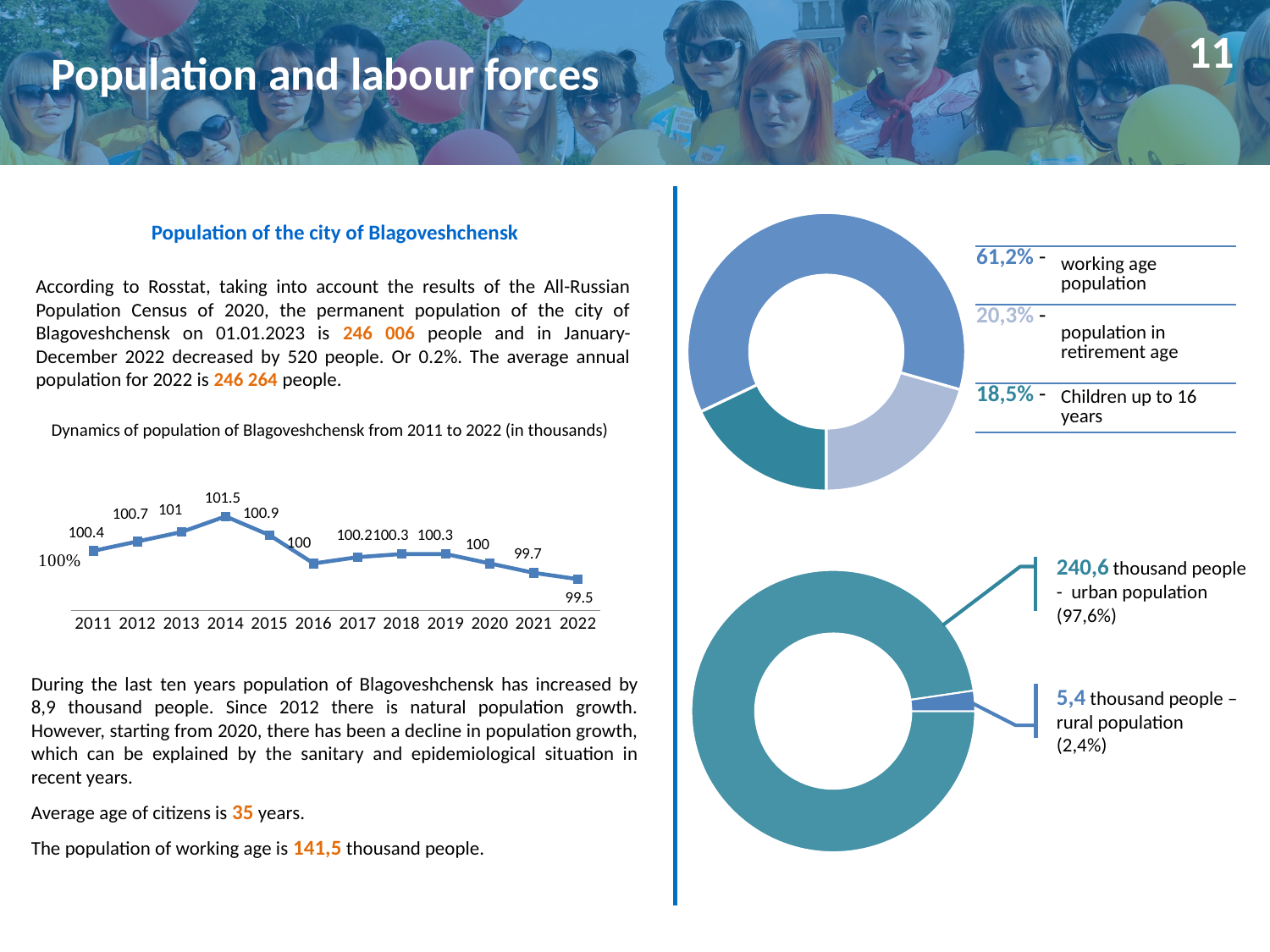
In the line chart 'Dynamics of population of Blagoveshchensk from 2011 to 2022', which year has the highest value? 2014 In the line chart 'Dynamics of population of Blagoveshchensk from 2011 to 2022', what is the value for 2022? 99.5 In the line chart 'Dynamics of population of Blagoveshchensk from 2011 to 2022', which is larger, the value for 2012 or the value for 2021? 2012 In the line chart 'Dynamics of population of Blagoveshchensk from 2011 to 2022', do the values rise or fall from 2019 to 2022? fall What kind of chart is 'Dynamics of population of Blagoveshchensk from 2011 to 2022'? line chart In the upper-right donut chart, which category has the smallest share? Children up to 16 years In the upper-right donut chart, what share is the working age population? 61,2% In the line chart 'Dynamics of population of Blagoveshchensk from 2011 to 2022', what is the difference between the values for 2014 and 2022? 2 In the line chart 'Dynamics of population of Blagoveshchensk from 2011 to 2022', what is the value for 2014? 101.5 How many years are plotted in the line chart 'Dynamics of population of Blagoveshchensk from 2011 to 2022'? 12 In the line chart 'Dynamics of population of Blagoveshchensk from 2011 to 2022', which year has the lowest value? 2022 In the lower-right donut chart, what is the value for the rural population in thousand people? 5,4